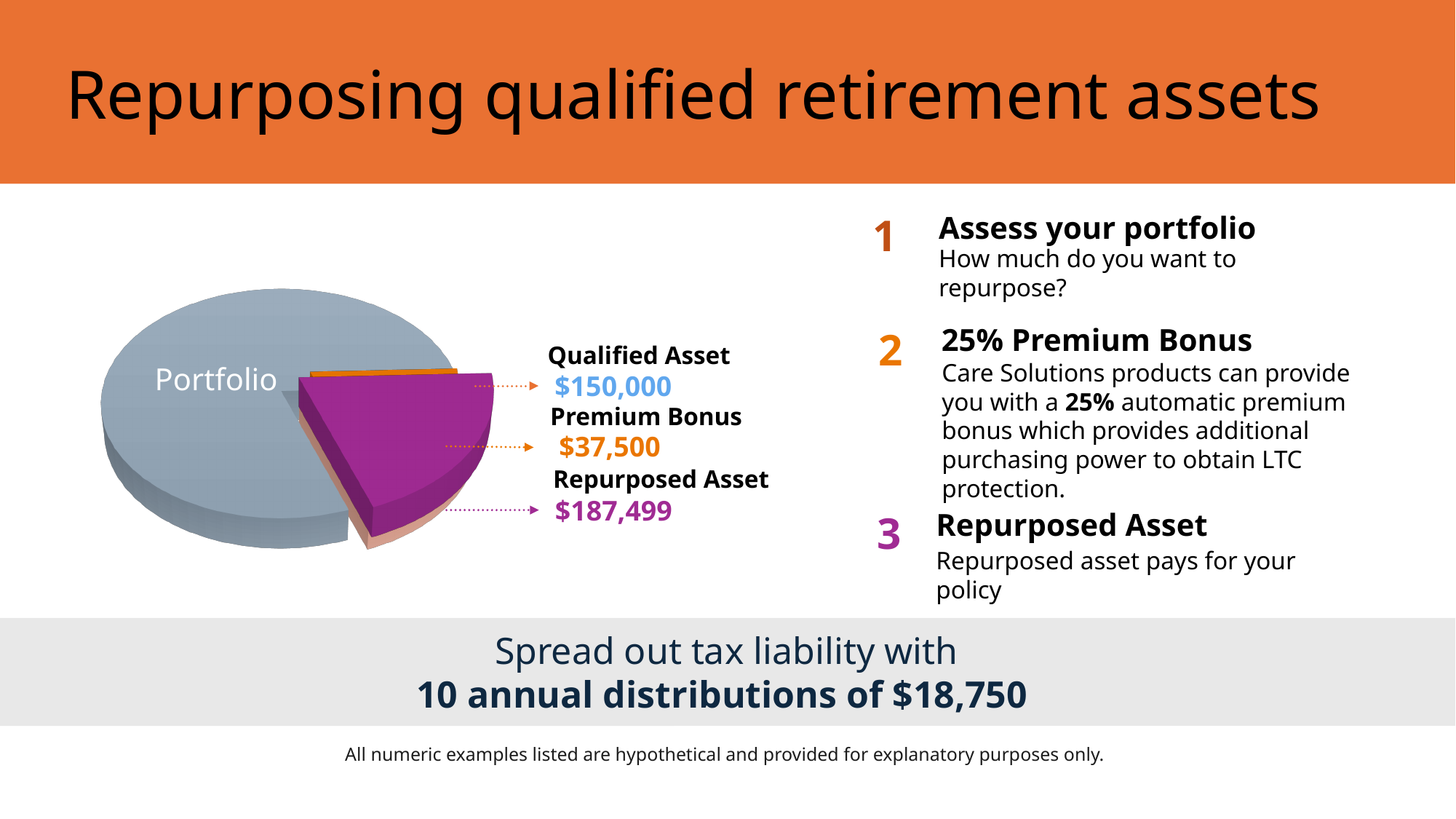
What is the difference between the Qualified Asset value and the Premium Bonus value? $112,500 What value is shown for Premium Bonus on the pie chart? $37,500 Which of the three labelled values on the pie chart is the largest? Repurposed Asset Which of the three labelled values on the pie chart is the smallest? Premium Bonus What value is shown for Repurposed Asset on the pie chart? $187,499 How many labelled values are called out next to the pie chart? 3 What value is shown for Qualified Asset on the pie chart? $150,000 What kind of chart is shown on the slide? Pie chart What label appears on the large grey portion of the pie chart? Portfolio What colour is the exploded slice of the pie chart that represents the Repurposed Asset? Purple What is the difference between the Repurposed Asset value and the Qualified Asset value? $37,499 Which is larger, the Qualified Asset value or the Premium Bonus value? Qualified Asset